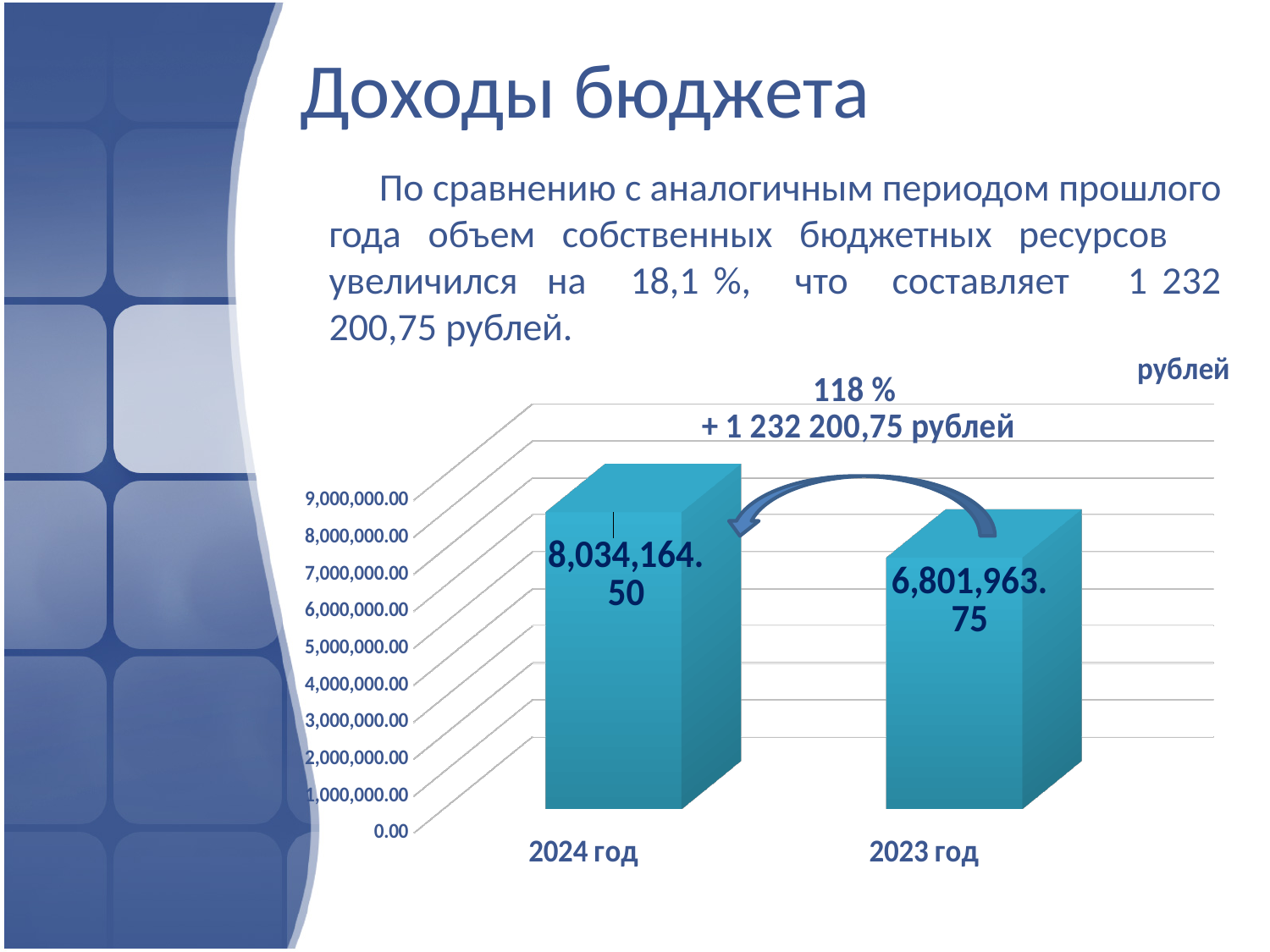
Is the value for 2024 год larger or smaller than the value for 2023 год? larger Which year has the higher value? 2024 год Is the value for 2024 год greater or less than 8,000,000.00? greater What kind of chart is shown on the slide? bar chart What percentage is printed above the bars in the chart? 118 % What is the value for 2024 год? 8,034,164.50 Which year has the lower value? 2023 год What is the highest value shown on the vertical axis? 9,000,000.00 What is the value for 2023 год? 6,801,963.75 What is the difference between the values for 2024 год and 2023 год? 1,232,200.75 Is the value for 2023 год greater or less than 7,000,000.00? less How many bars are shown in the chart? 2